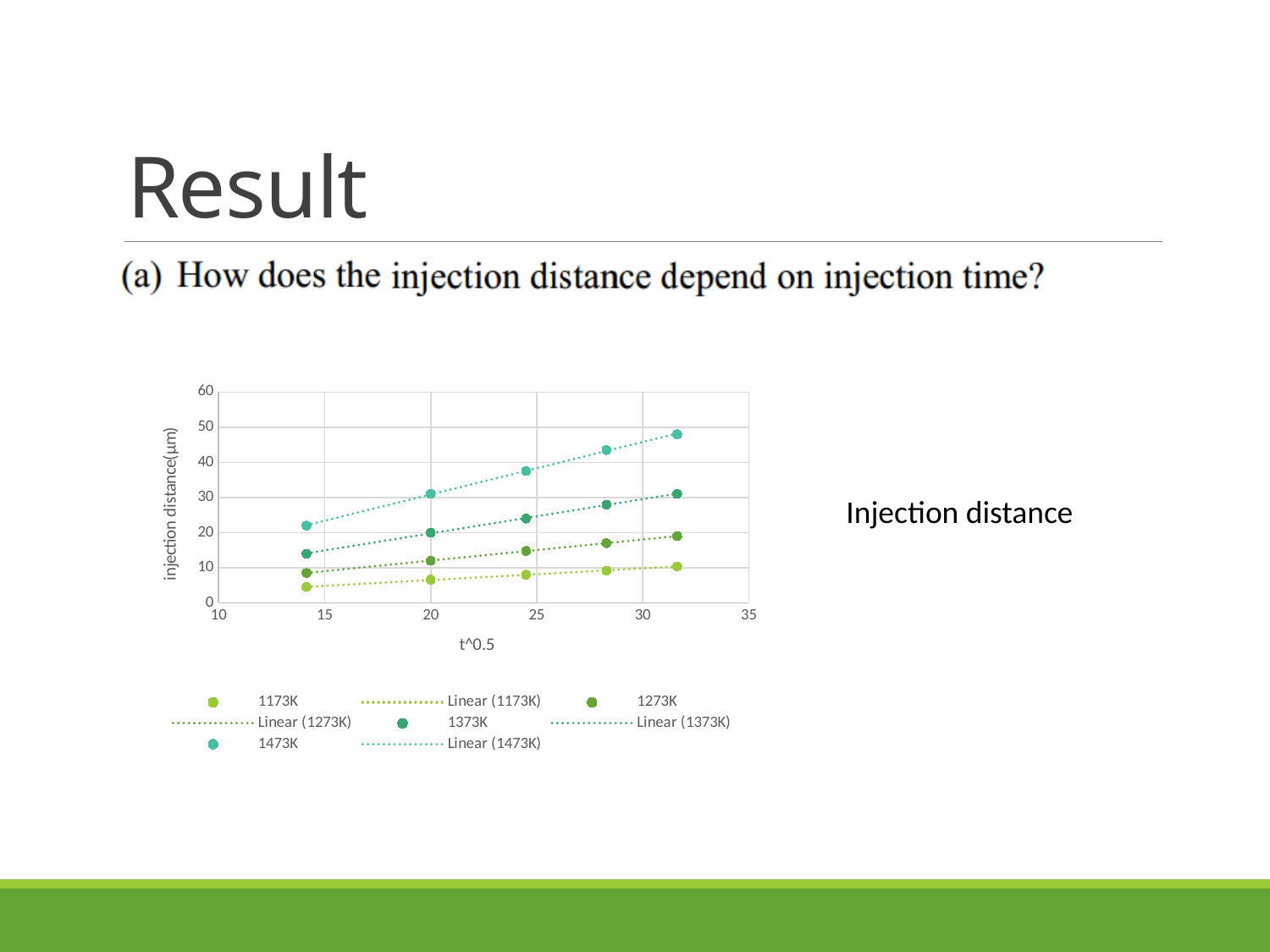
At the rightmost data point, which series has the larger injection distance, 1373K or 1273K? 1373K How many data points are plotted for the 1473K series? 5 Which series has the highest injection distance values across the chart? 1473K Is the injection distance for the 1473K series at t^0.5 of about 24.5 greater or less than 30? greater What kind of chart is shown on the slide? scatter chart How many entries does the chart legend list? 8 Which series has the lowest injection distance values across the chart? 1173K Do the injection distance values for the 1473K series rise or fall as t^0.5 increases? rise What is the label on the y axis of the chart? injection distance(μm) Is the injection distance for the 1473K series at its rightmost point greater or less than 40? greater What is the label on the x axis of the chart? t^0.5 Is the injection distance for the 1173K series at its leftmost point greater or less than 10? less